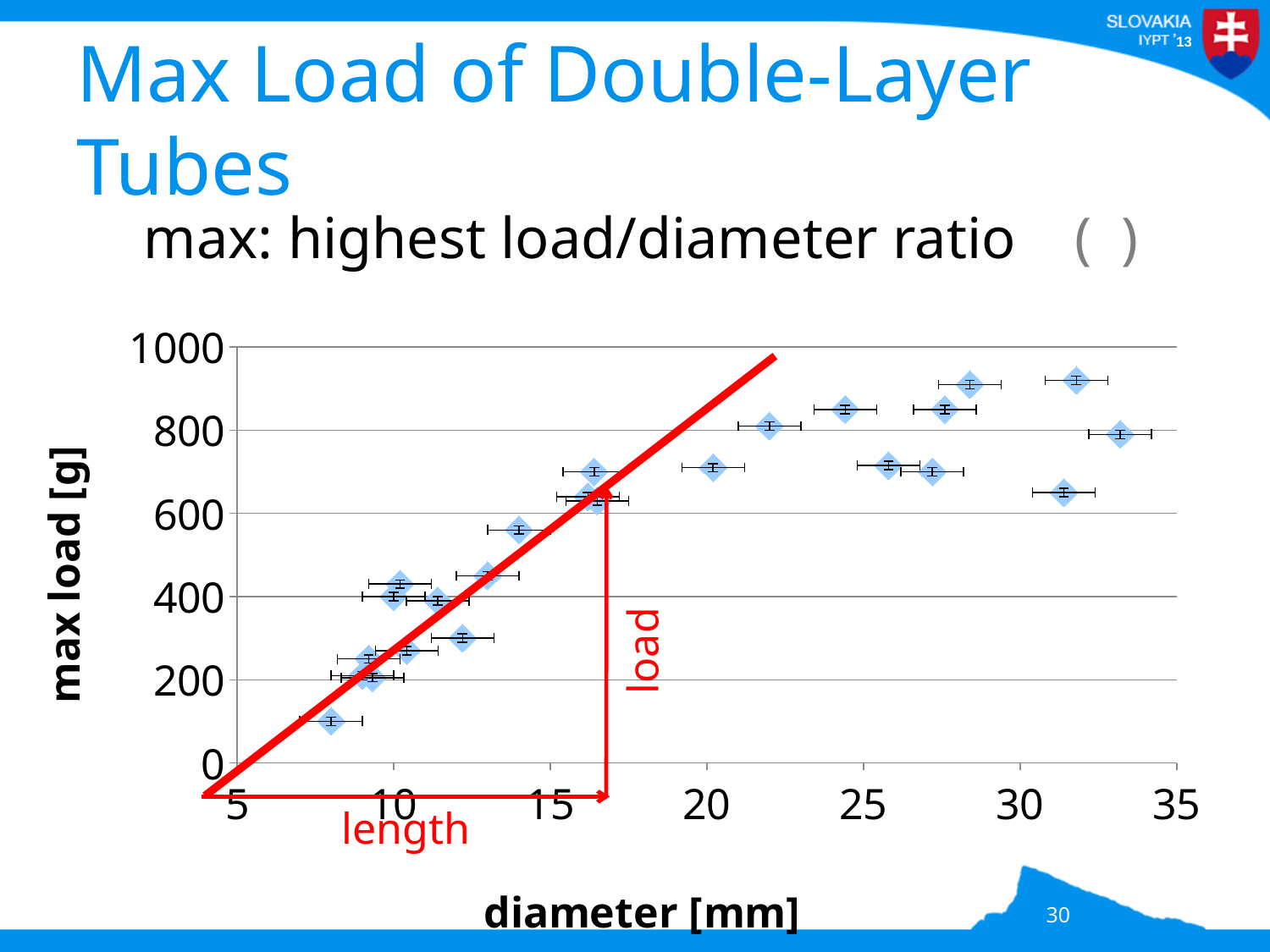
What is the label of the x axis of the chart? diameter [mm] Is the max load of the lowest point plotted near 31 mm diameter greater or less than 800 g? less What is the highest value shown on the y axis of the chart? 1000 Which has the larger max load: the point near 8 mm diameter or the point near 28 mm diameter? the point near 28 mm What is the label of the y axis of the chart? max load [g] Is the max load of the point plotted near 20 mm diameter greater or less than 600 g? greater Is the max load of the highest point plotted near 32 mm diameter greater or less than 800 g? greater What kind of chart is shown on the slide? scatter plot Overall, do the max load values rise or fall as the diameter increases along the x axis? rise